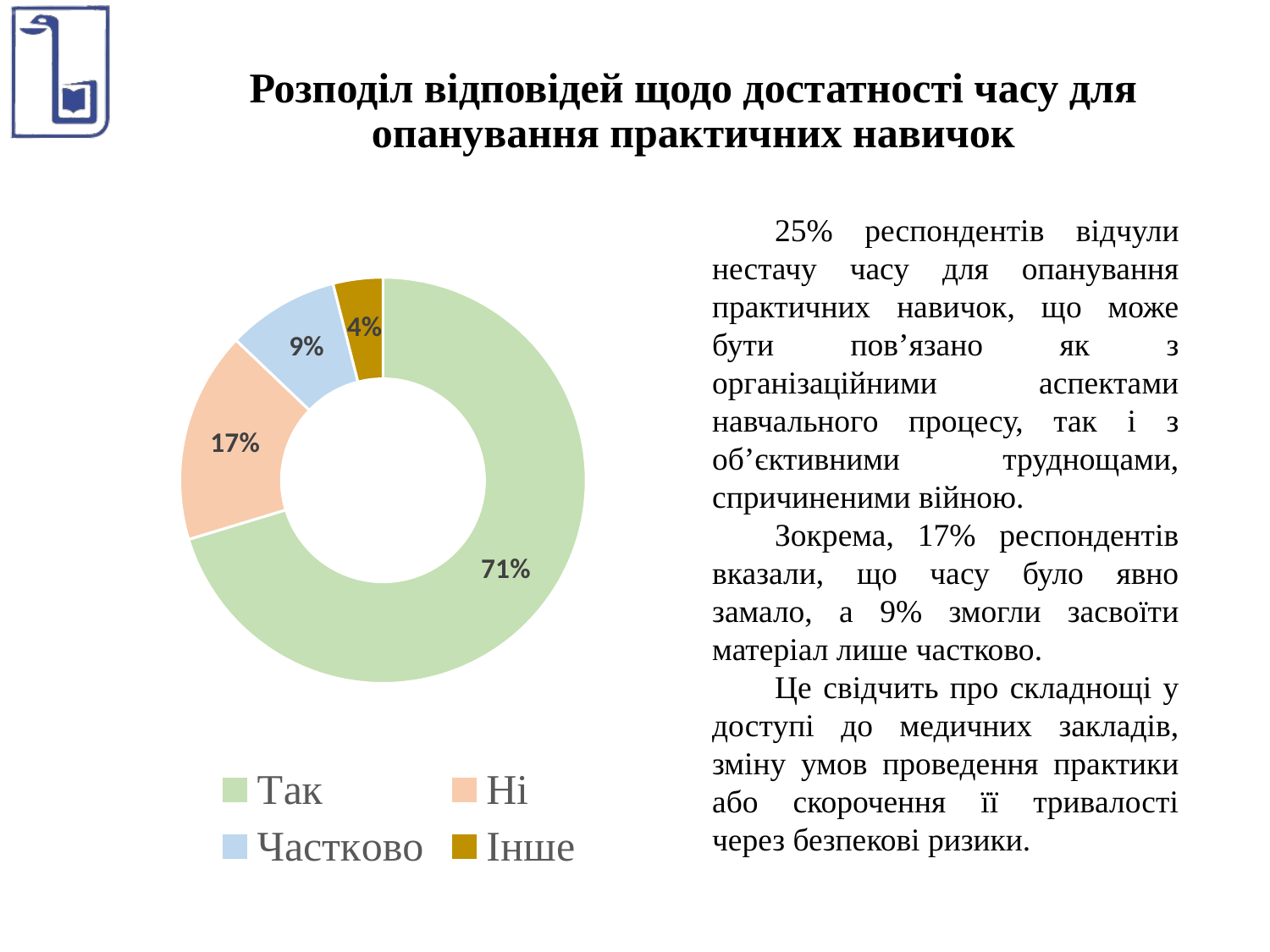
How many categories does the chart show? 4 Which is larger, the share for "Частково" or the share for "Інше"? Частково What is the difference in percentage points between "Ні" and "Частково"? 8 What percentage of respondents answered "Частково"? 9% Which category has the largest share of the chart? Так What percentage of respondents answered "Інше"? 4% Which category has the smallest share of the chart? Інше What kind of chart is shown on the slide? Doughnut chart What percentage of respondents answered "Ні"? 17% What is the difference in percentage points between "Так" and "Ні"? 54 What percentage of respondents answered "Так"? 71% What colour is the "Інше" segment in the chart? Dark yellow